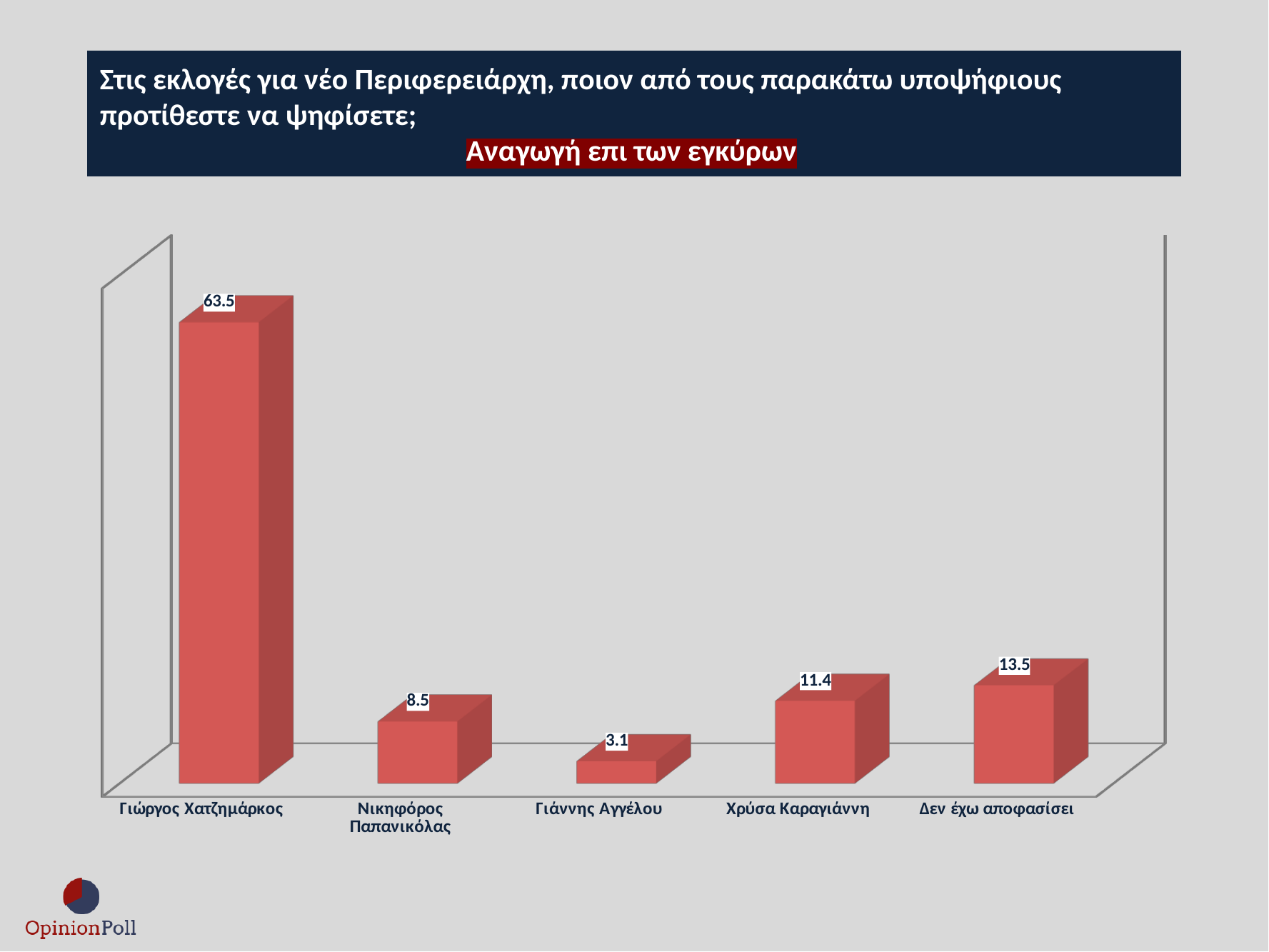
What is the value for Γιάννης Αγγέλου? 3.1 Which category has the highest value? Γιώργος Χατζημάρκος What is the difference between the values for Γιώργος Χατζημάρκος and Δεν έχω αποφασίσει? 50 What kind of chart is shown on the slide? Bar chart Which is larger, the value for Χρύσα Καραγιάννη or the value for Δεν έχω αποφασίσει? Δεν έχω αποφασίσει Which category has the lowest value? Γιάννης Αγγέλου What is the value for Χρύσα Καραγιάννη? 11.4 How many categories are shown on the chart? 5 What is the value for Γιώργος Χατζημάρκος? 63.5 What is the value for Νικηφόρος Παπανικόλας? 8.5 What is the value for Δεν έχω αποφασίσει? 13.5 What is the difference between the values for Χρύσα Καραγιάννη and Νικηφόρος Παπανικόλας? 2.9